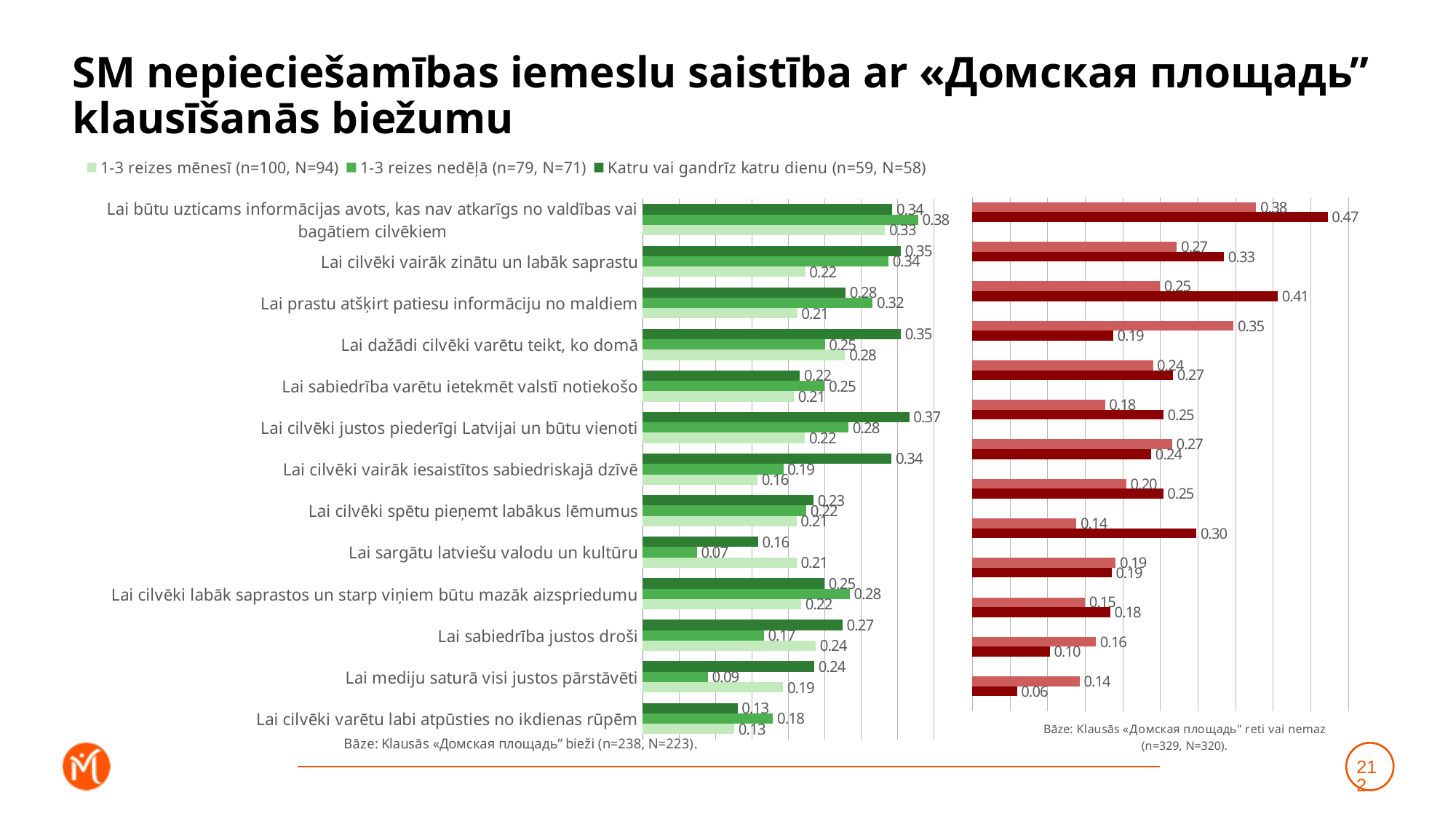
In the left (green) chart, what is the value for 'Lai cilvēki justos piederīgi Latvijai un būtu vienoti' in the 'Katru vai gandrīz katru dienu' series? 0.37 How many categories are listed on the left (green) chart? 13 In the right (red) chart, what is the difference between the darker red and lighter red bars for 'Lai sargātu latviešu valodu un kultūru'? 0.16 How many series does the legend above the left (green) chart list? 3 In the right (red) chart, what is the value of the darker red bar for 'Lai prastu atšķirt patiesu informāciju no maldiem'? 0.41 What type of chart is used on this slide? Bar chart In the left (green) chart, what is the difference between the 'Katru vai gandrīz katru dienu' and '1-3 reizes mēnesī' values for 'Lai cilvēki vairāk iesaistītos sabiedriskajā dzīvē'? 0.18 In the right (red) chart, which category has the lowest value for the darker red bar? Lai cilvēki varētu labi atpūsties no ikdienas rūpēm In the left (green) chart, which category has the highest value in the 'Katru vai gandrīz katru dienu' series? Lai cilvēki justos piederīgi Latvijai un būtu vienoti In the left (green) chart, for 'Lai sabiedrība justos droši', which series has the larger value: 'Katru vai gandrīz katru dienu' or '1-3 reizes nedēļā'? Katru vai gandrīz katru dienu In the left (green) chart, what is the value for 'Lai būtu uzticams informācijas avots, kas nav atkarīgs no valdības vai bagātiem cilvēkiem' in the '1-3 reizes mēnesī' series? 0.33 In the left (green) chart, what is the value for 'Lai sargātu latviešu valodu un kultūru' in the '1-3 reizes nedēļā' series? 0.07